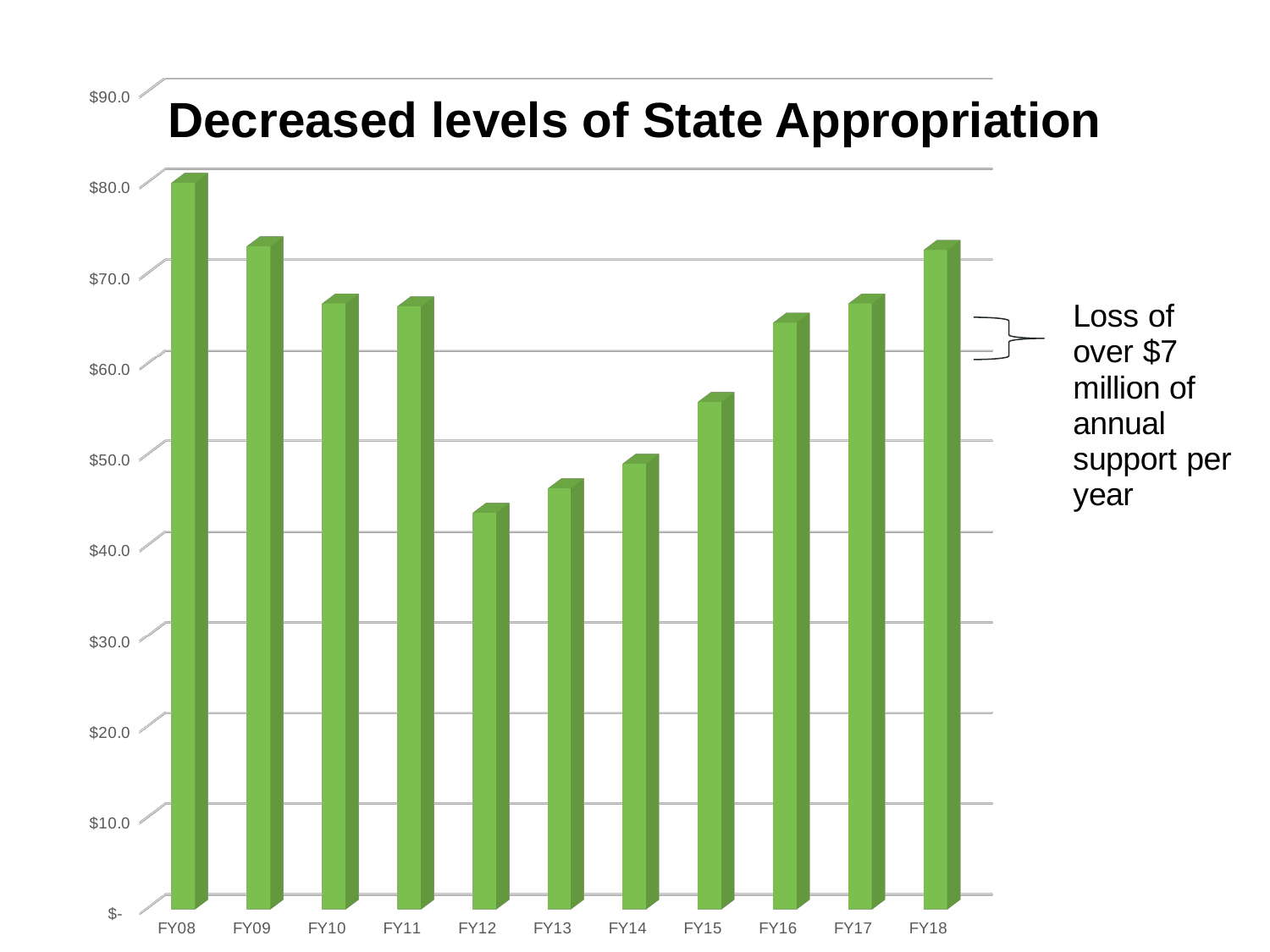
Which is larger, the value for FY08 or the value for FY12? FY08 Do the values rise or fall from FY12 to FY18? rise How many fiscal years are plotted on the x axis? 11 Is the value for FY12 greater or less than $50.0? less What kind of chart is shown on the slide? Bar chart Is the value for FY16 greater or less than $60.0? greater Is the value for FY08 greater or less than $70.0? greater Which fiscal year has the lowest state appropriation? FY12 Which fiscal year has the highest state appropriation? FY08 Which is larger, the value for FY18 or the value for FY10? FY18 What is the title of the chart? Decreased levels of State Appropriation